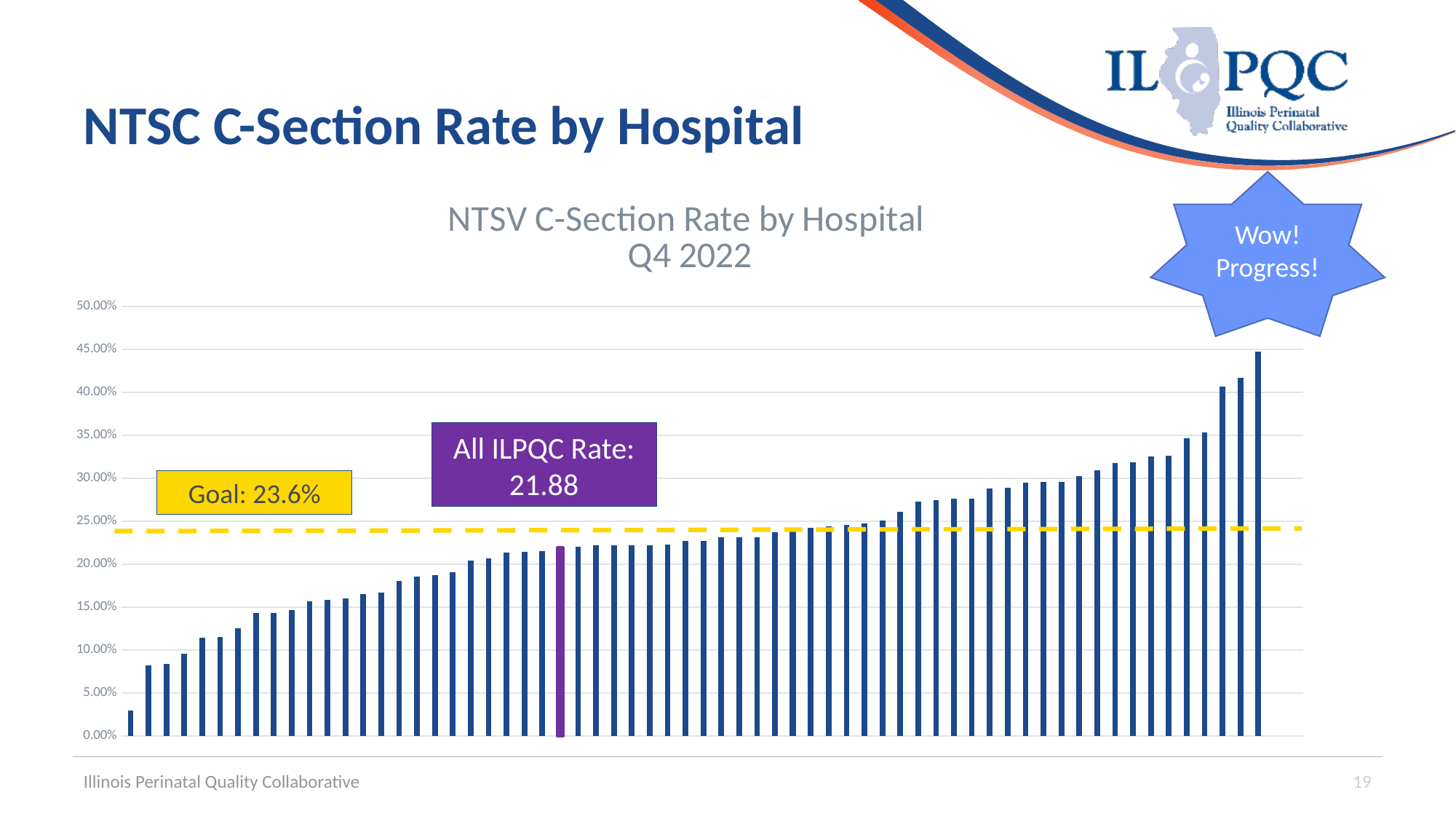
Is the value of the tallest bar greater or less than 40.00%? greater What kind of chart is shown on the slide? Bar chart Do the bar values rise or fall from left to right along the x axis? Rise What is the highest value shown on the y axis? 50.00% What value is shown in the 'All ILPQC Rate' box on the chart? 21.88 Is the goal of 23.6% greater or less than the All ILPQC Rate of 21.88? greater Which bar is the highest: the leftmost bar or the rightmost bar? The rightmost bar Is the value of the purple highlighted bar greater or less than 25.00%? less What goal value is shown on the chart? 23.6% Is the value of the shortest bar (leftmost) greater or less than 5.00%? less What is the title of the chart? NTSV C-Section Rate by Hospital Q4 2022